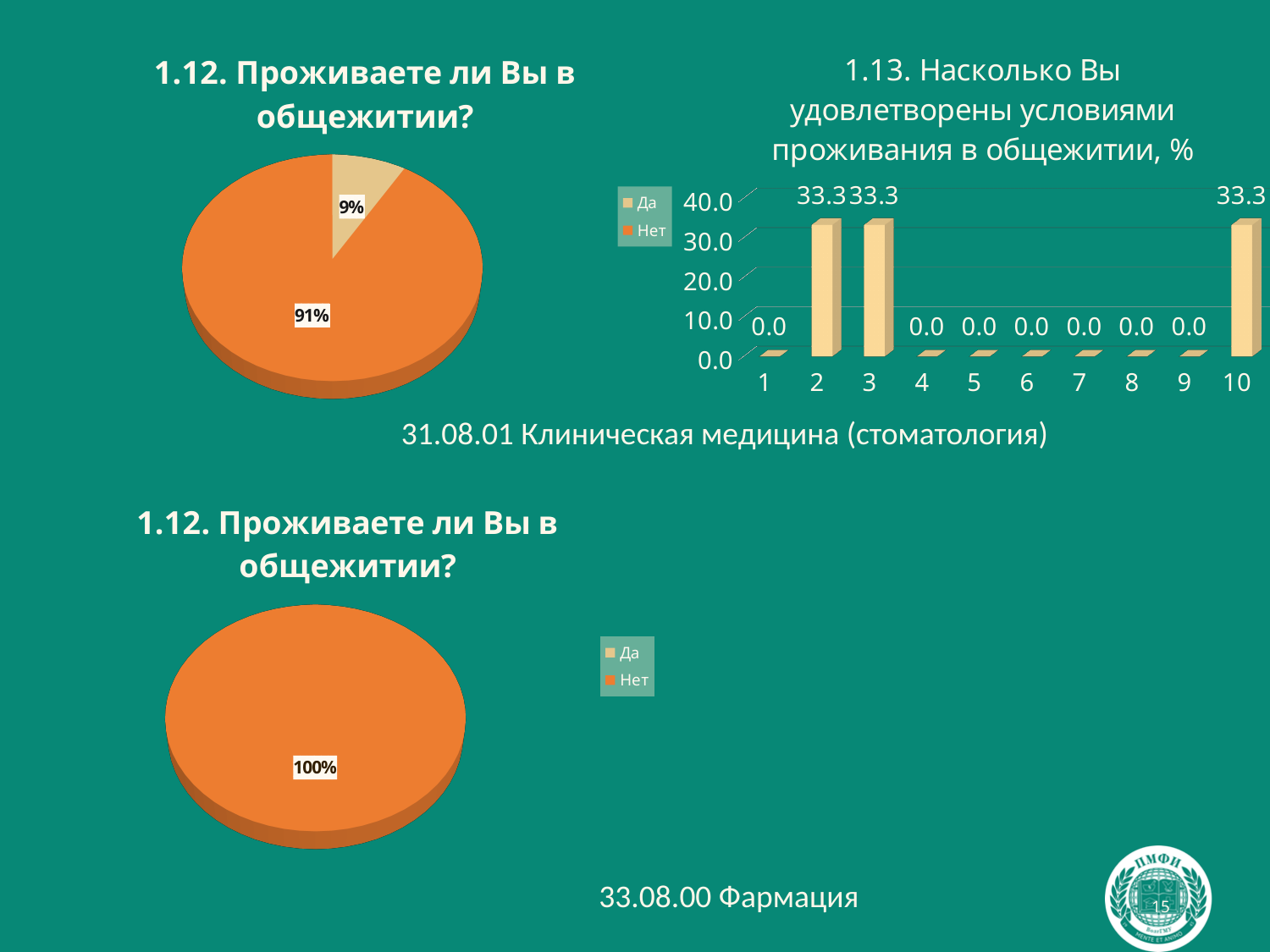
In the top-left pie chart '1.12. Проживаете ли Вы в общежитии?' (31.08.01 Клиническая медицина), what share is labelled for the 'Да' slice? 9% In the bar chart '1.13. Насколько Вы удовлетворены условиями проживания в общежитии, %', what is the value for category 10? 33.3 In the bottom-left pie chart '1.12. Проживаете ли Вы в общежитии?' (33.08.00 Фармация), what share is labelled for the 'Нет' slice? 100% In the bar chart '1.13. Насколько Вы удовлетворены условиями проживания в общежитии, %', how many categories are shown on the x axis? 10 In the bar chart '1.13. Насколько Вы удовлетворены условиями проживания в общежитии, %', what is the value for category 2? 33.3 In the top-left pie chart '1.12. Проживаете ли Вы в общежитии?', which slice is larger, 'Да' or 'Нет'? Нет In the bar chart '1.13. Насколько Вы удовлетворены условиями проживания в общежитии, %', what is the value for category 5? 0.0 In the bar chart '1.13. Насколько Вы удовлетворены условиями проживания в общежитии, %', what is the difference between the value for category 3 and the value for category 4? 33.3 In the top-left pie chart '1.12. Проживаете ли Вы в общежитии?' (31.08.01 Клиническая медицина), what share is labelled for the 'Нет' slice? 91% How many entries does the legend of the top-left pie chart '1.12. Проживаете ли Вы в общежитии?' list? 2 What kind of chart is the chart titled '1.13. Насколько Вы удовлетворены условиями проживания в общежитии, %'? bar chart In the bar chart '1.13. Насколько Вы удовлетворены условиями проживания в общежитии, %', is the value for category 2 greater or less than 30.0? greater